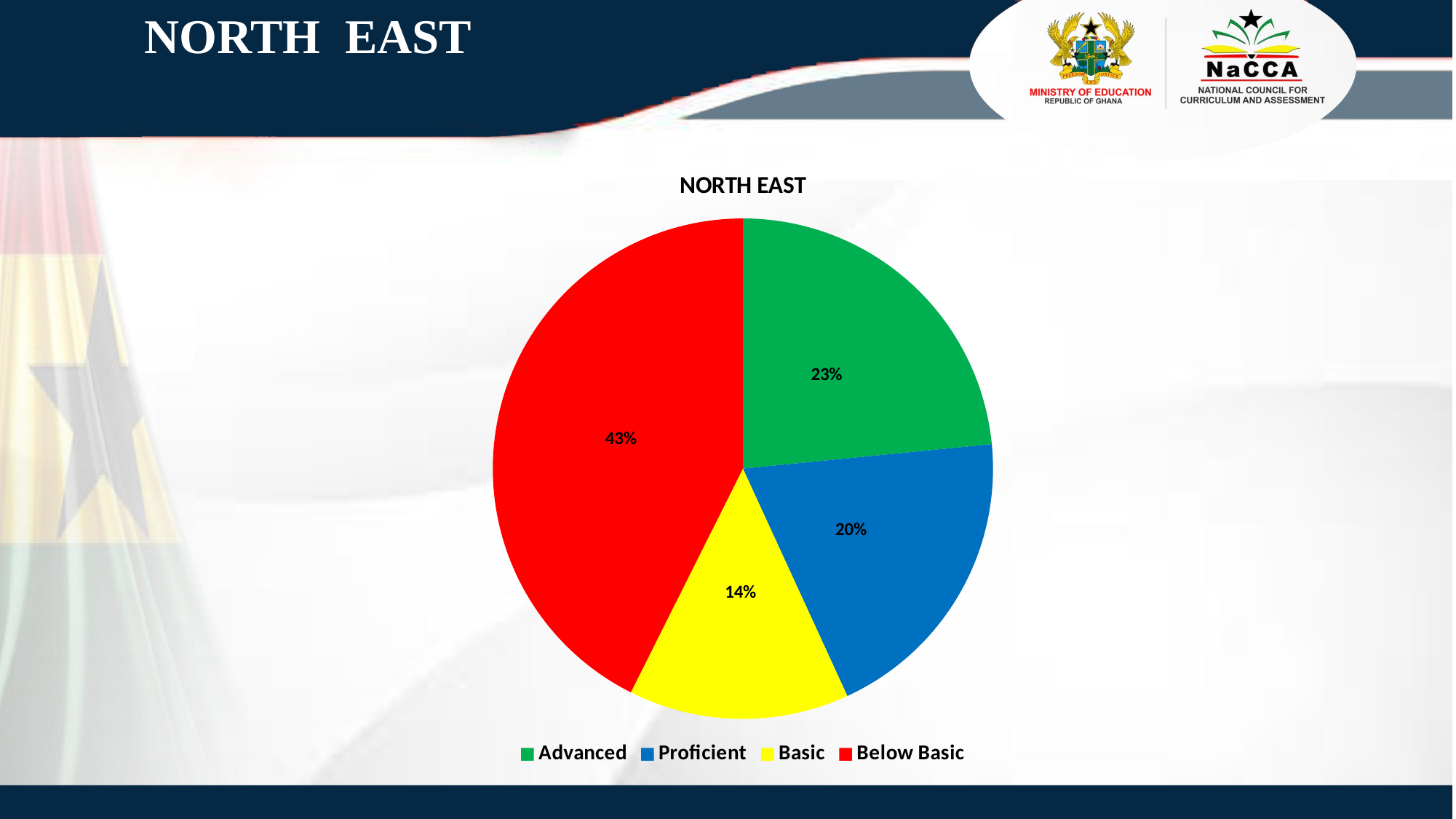
What is the title of the chart? NORTH EAST What percentage of the pie is Below Basic? 43% What type of chart is shown on the slide? Pie chart Which is larger, the Proficient share or the Basic share? Proficient How many categories does the pie chart have? 4 What colour is the Below Basic slice? Red Which category has the smallest share of the pie? Basic What percentage of the pie is Advanced? 23% What percentage of the pie is Proficient? 20% What is the difference in percentage points between Below Basic and Advanced? 20 What percentage of the pie is Basic? 14% Which category has the largest share of the pie? Below Basic